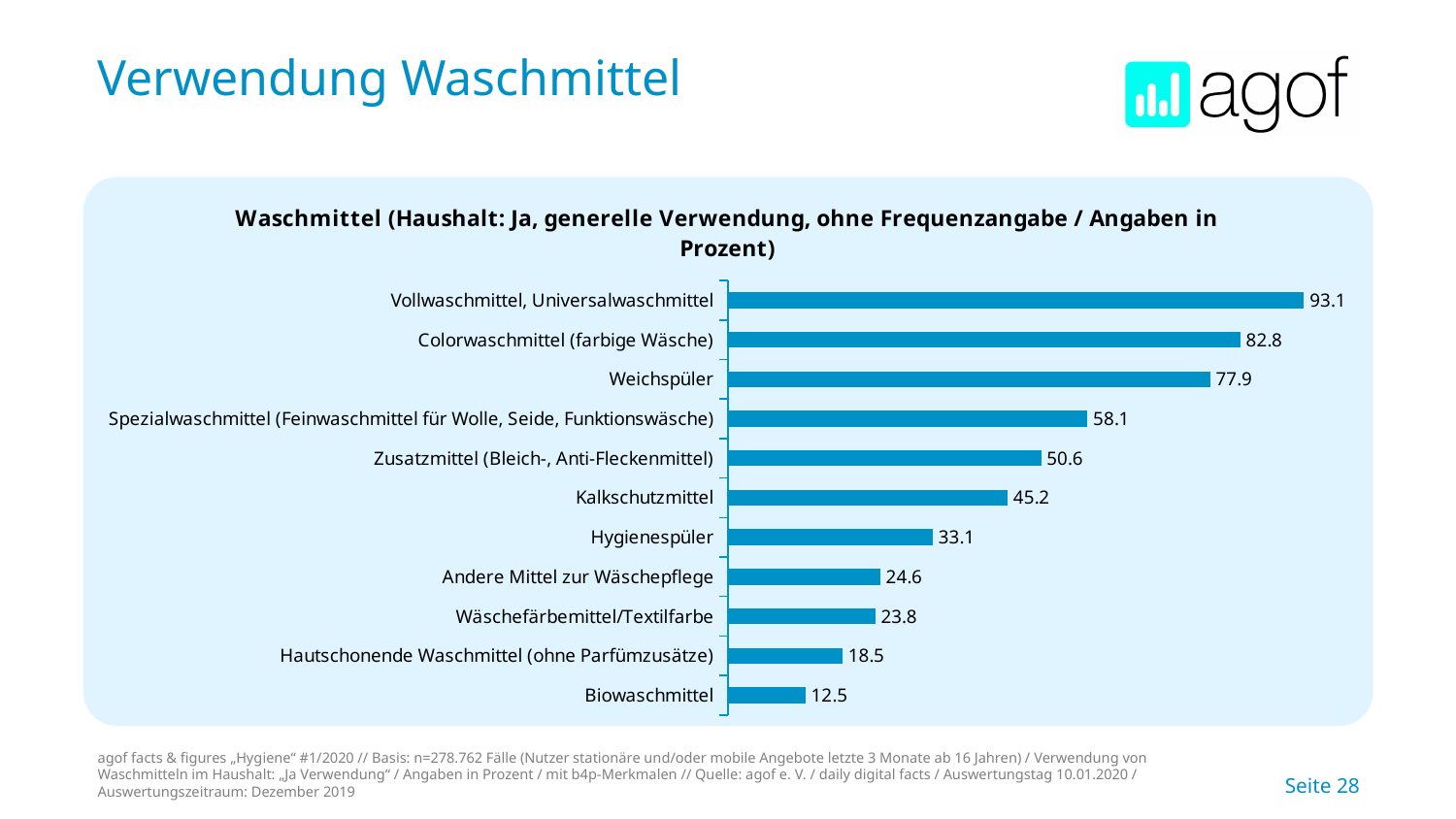
What is the title of the chart? Waschmittel (Haushalt: Ja, generelle Verwendung, ohne Frequenzangabe / Angaben in Prozent) What is the value for Weichspüler? 77.9 What is the value for Hautschonende Waschmittel (ohne Parfümzusätze)? 18.5 What is the value for Kalkschutzmittel? 45.2 Which category has the lowest value? Biowaschmittel How many categories are shown in the chart? 11 What kind of chart is shown on the slide? Bar chart What is the difference between the values for Colorwaschmittel (farbige Wäsche) and Weichspüler? 4.9 What is the difference between the values for Hygienespüler and Biowaschmittel? 20.6 What is the value for Biowaschmittel? 12.5 Which is larger, the value for Zusatzmittel (Bleich-, Anti-Fleckenmittel) or the value for Kalkschutzmittel? Zusatzmittel (Bleich-, Anti-Fleckenmittel) Which category has the highest value? Vollwaschmittel, Universalwaschmittel